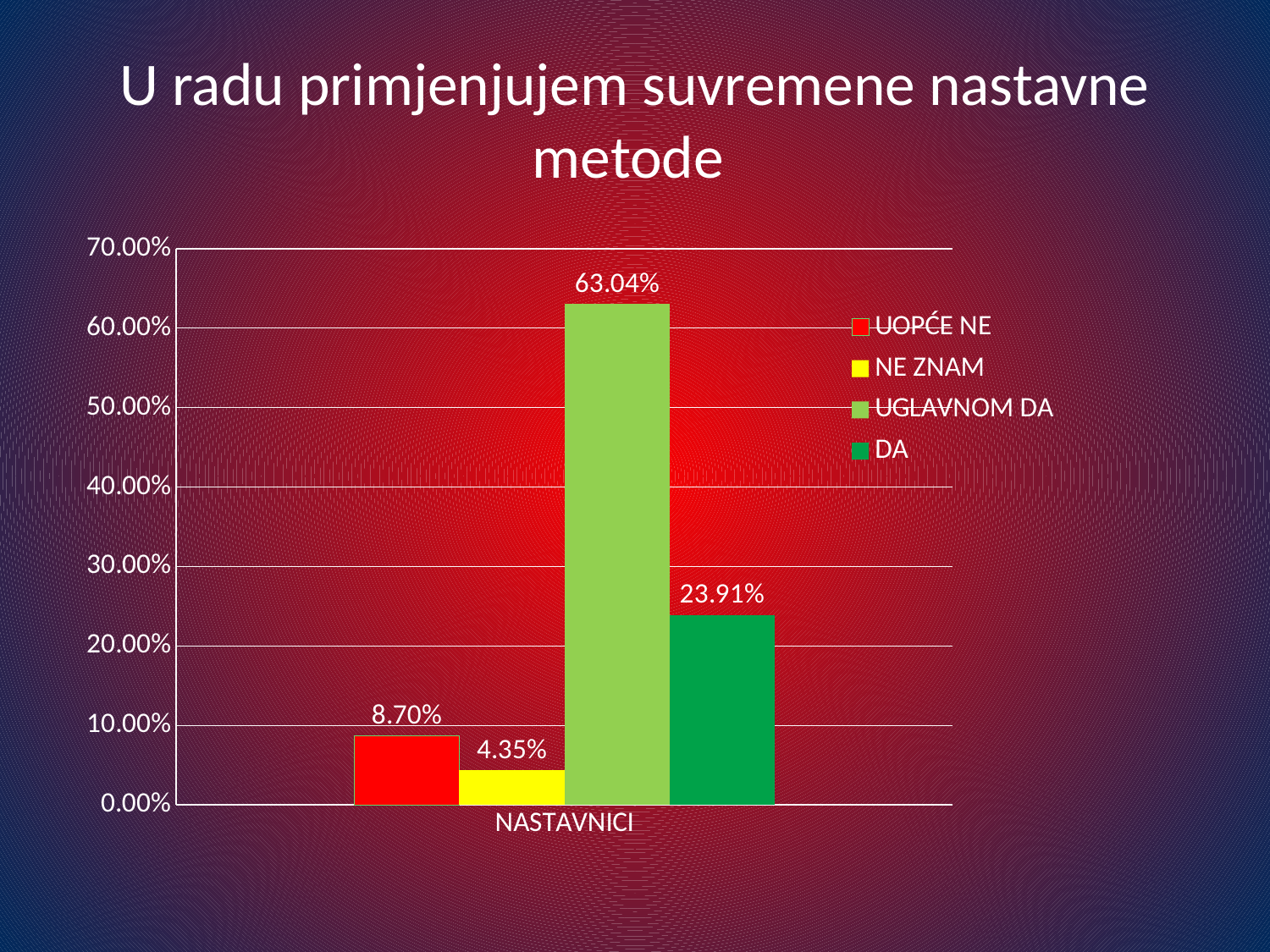
What is the value for NE ZNAM? 4.35% What is the difference between the values for UOPĆE NE and NE ZNAM? 4.35% Which series has the lowest value? NE ZNAM What is the value for UOPĆE NE? 8.70% How many series does the legend list? 4 Which series has the highest value? UGLAVNOM DA What is the value for DA? 23.91% Which is larger, the value for DA or the value for UOPĆE NE? DA What is the value for UGLAVNOM DA? 63.04% What is the difference between the values for UGLAVNOM DA and DA? 39.13% What kind of chart is shown on the slide? Bar chart What is the category label shown on the x axis? NASTAVNICI